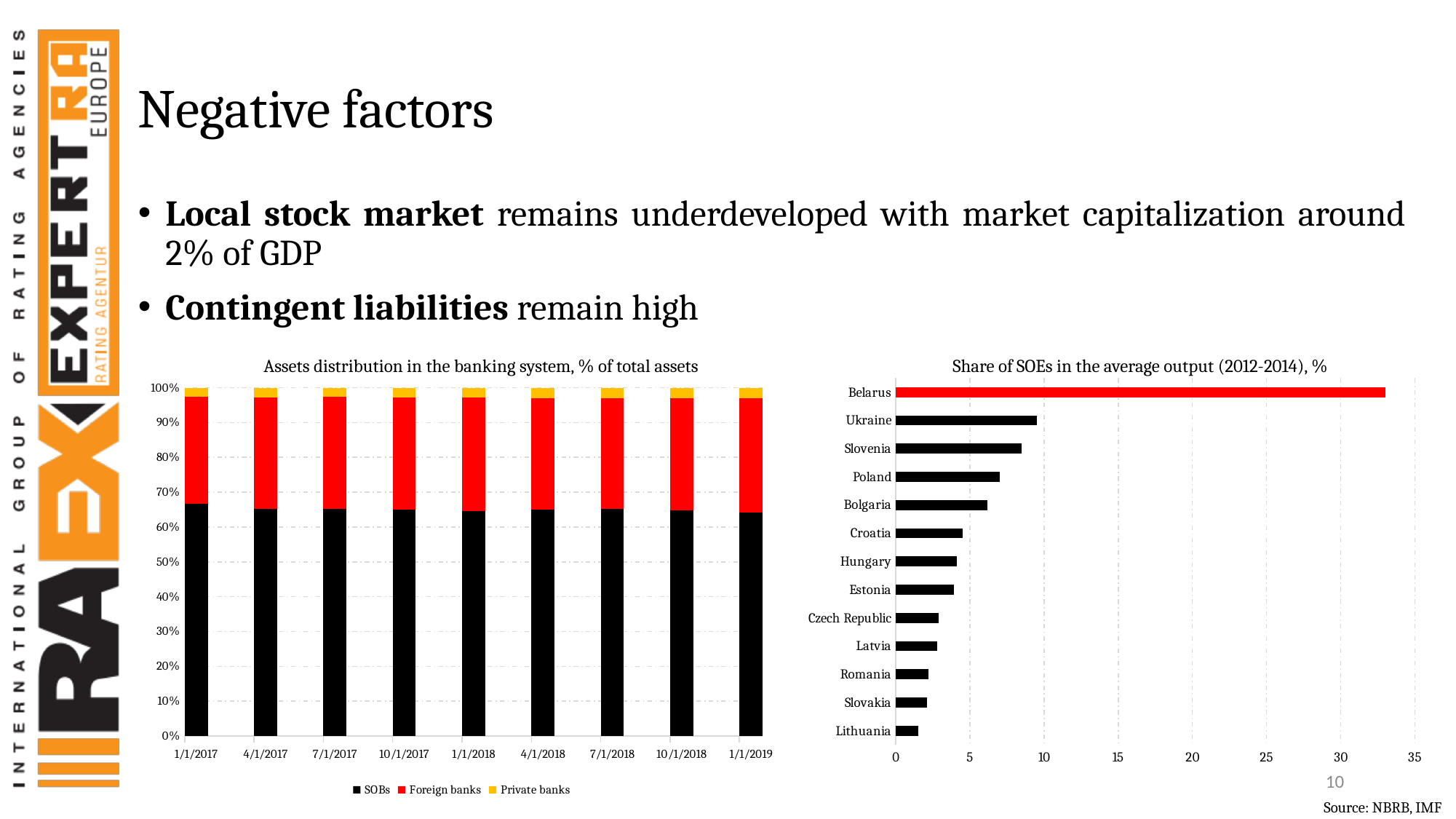
How many dates are shown on the x axis of the 'Assets distribution in the banking system' chart? 9 How many series does the legend of the 'Assets distribution in the banking system' chart list? 3 In the 'Assets distribution in the banking system' chart, which colour represents Foreign banks? Red In the 'Share of SOEs in the average output (2012-2014), %' chart, which country has the lowest value? Lithuania What kind of chart is the 'Share of SOEs in the average output (2012-2014), %' chart? Bar chart In the 'Assets distribution in the banking system' chart, is the SOBs share on 1/1/2017 greater or less than 60%? greater In the 'Share of SOEs in the average output (2012-2014), %' chart, which is larger, the value for Ukraine or the value for Slovenia? Ukraine In the 'Share of SOEs in the average output (2012-2014), %' chart, which country has the highest value? Belarus In the 'Share of SOEs in the average output (2012-2014), %' chart, is the value for Belarus greater or less than 30? greater What kind of chart is the 'Assets distribution in the banking system, % of total assets' chart? Stacked bar chart In the 'Share of SOEs in the average output (2012-2014), %' chart, is the value for Ukraine greater or less than 10? less How many countries are shown in the 'Share of SOEs in the average output (2012-2014), %' chart? 13